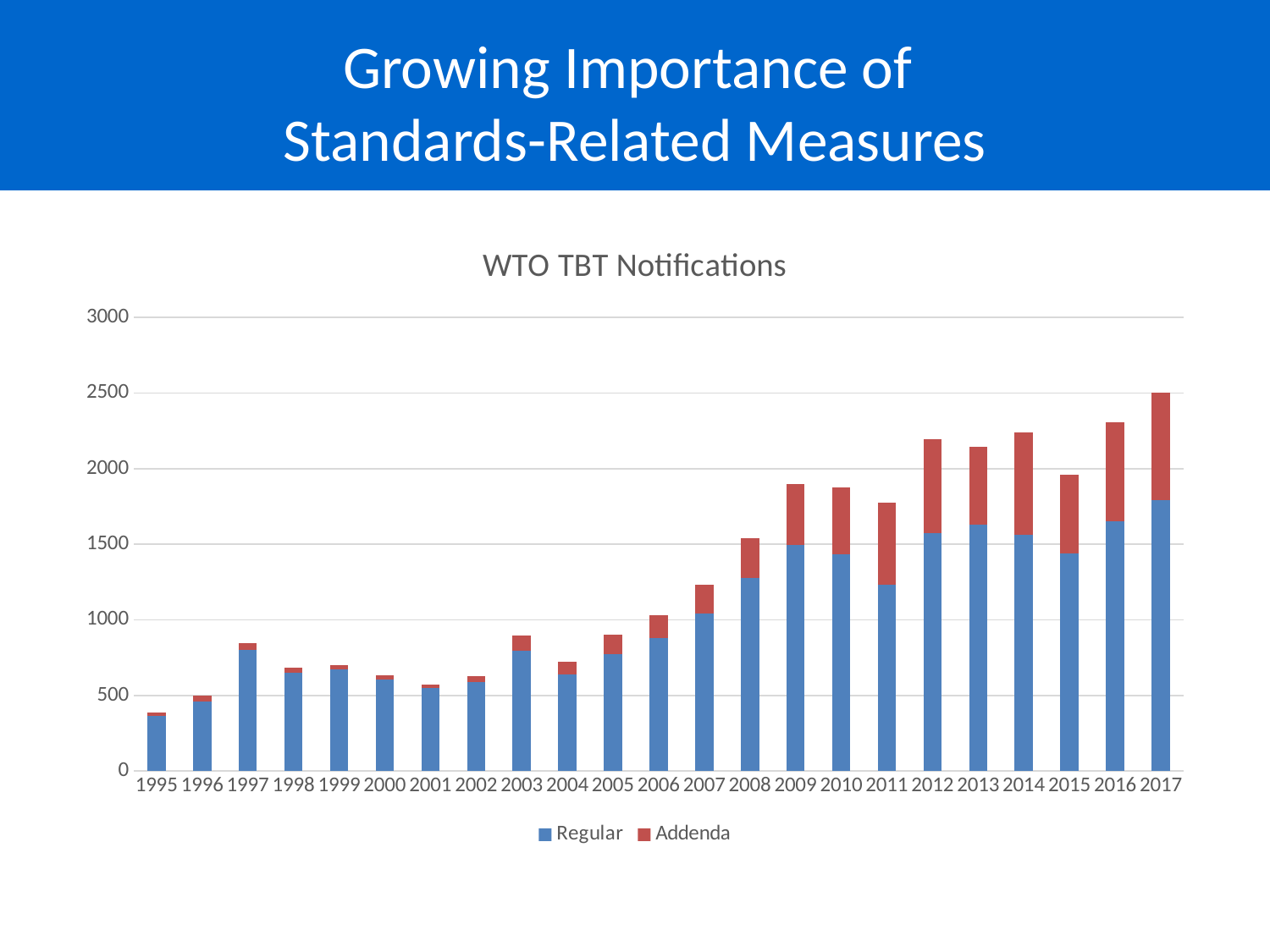
Which year has the larger total, 2015 or 2016? 2016 How many years are shown on the x axis? 23 Is the total value for 1995 greater or less than 500? less Do the total notifications generally rise or fall from 1995 to 2017? rise Is the Regular value for 2011 greater or less than 1500? less Which year has the highest total number of notifications? 2017 What kind of chart is shown on the slide? Stacked bar chart How many series does the legend list? 2 Is the total value for 2017 greater or less than 2000? greater Which year has the lowest total number of notifications? 1995 Which series are listed in the legend? Regular and Addenda What is the title of the chart? WTO TBT Notifications